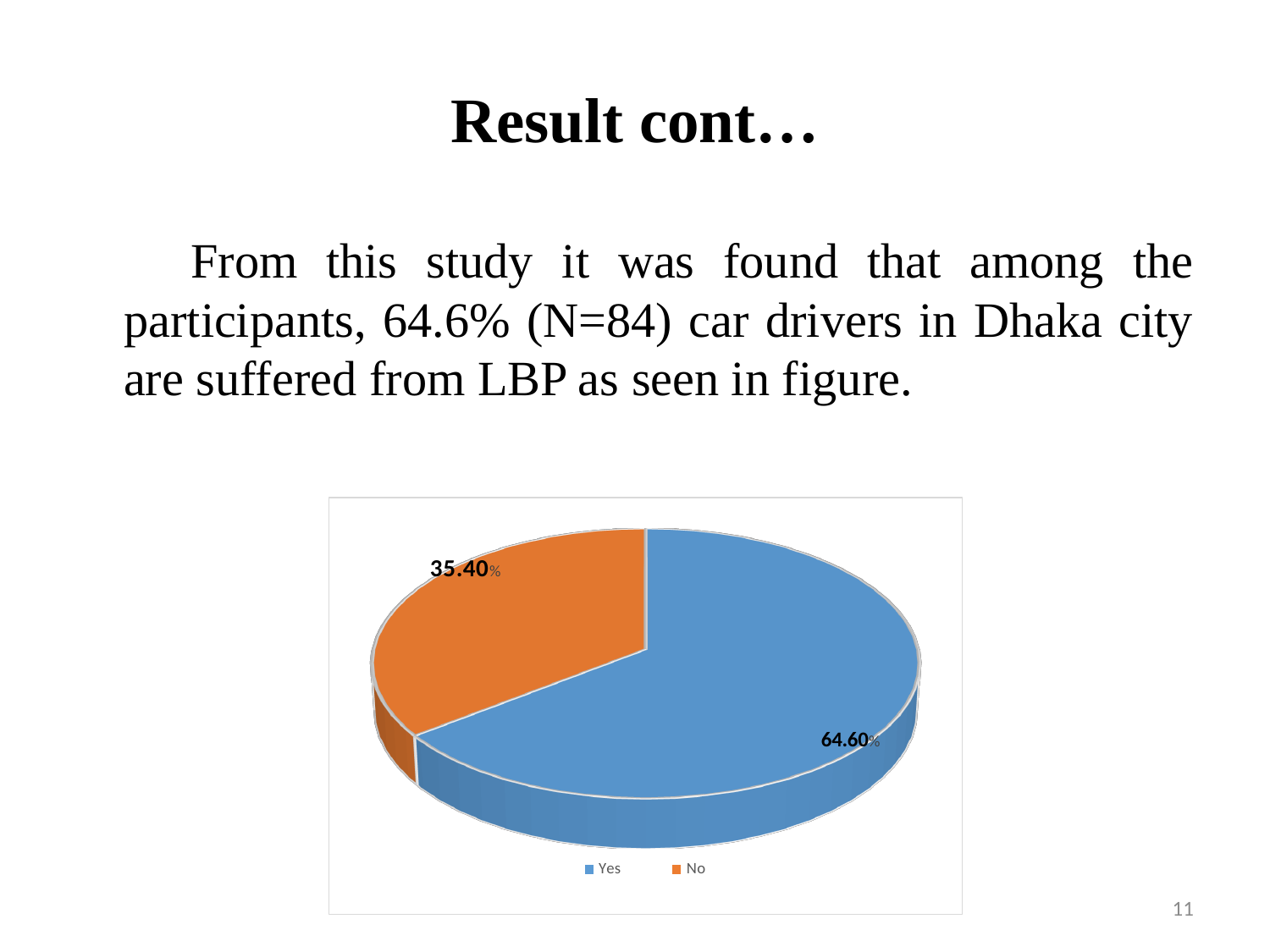
How many entries does the legend of the pie chart list? 2 What is the value for Yes in the pie chart? 64.60% What is the value for No in the pie chart? 35.40% What colour is the No slice in the pie chart? orange Which slice of the pie chart is the largest? Yes What kind of chart is shown on the slide? pie chart Which is larger in the pie chart, Yes or No? Yes What share of the pie does the Yes slice represent? 64.60% Which slice of the pie chart is the smallest? No What is the difference between the Yes and No values in the pie chart? 29.20% How many slices does the pie chart have? 2 What colour is the Yes slice in the pie chart? blue